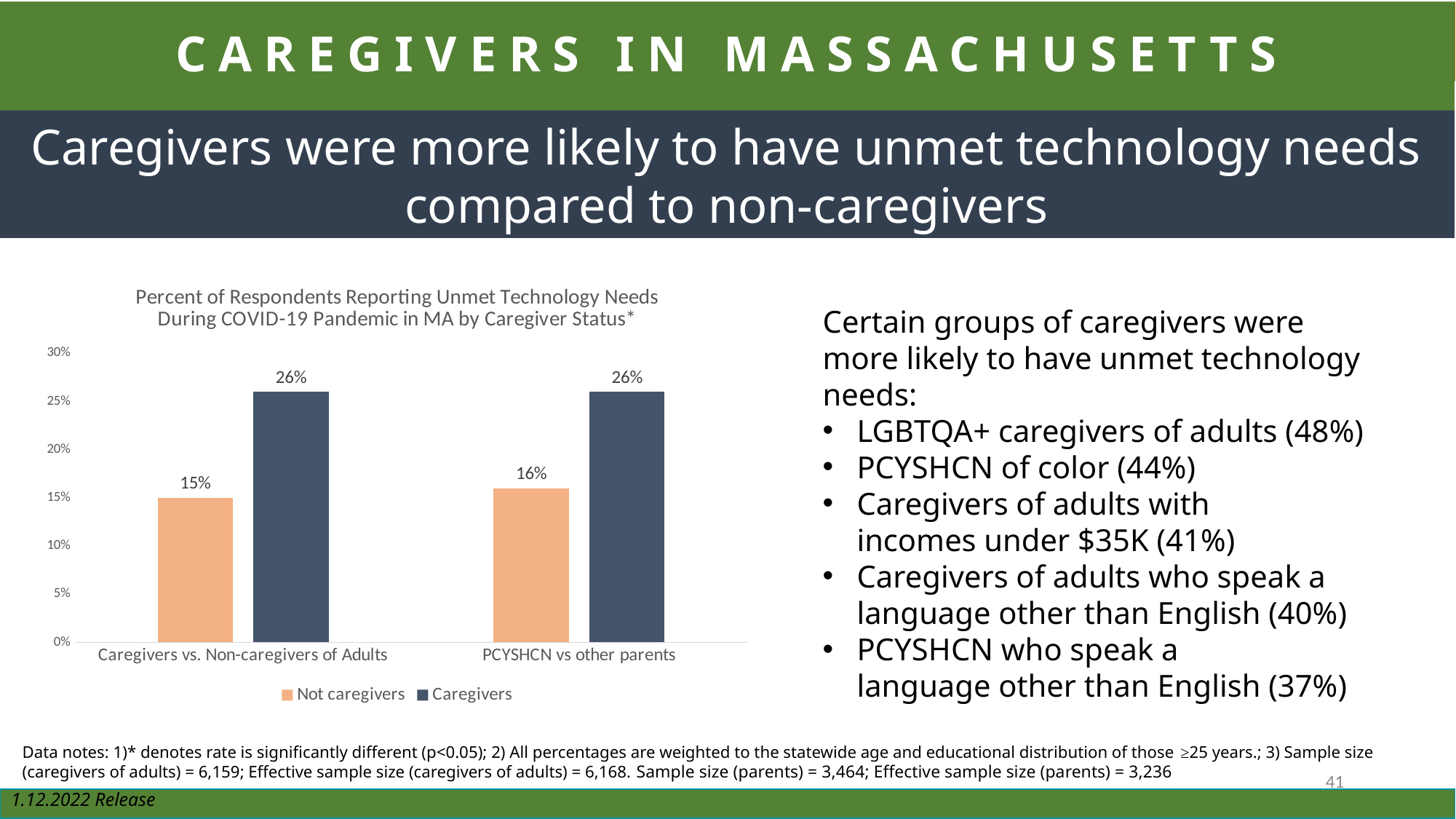
What type of chart is shown on the slide? Bar chart What colour represents the 'Not caregivers' series in the chart? Orange What is the difference between the 'Caregivers' and 'Not caregivers' values in the 'PCYSHCN vs other parents' category? 10% Is the value for 'Not caregivers' in the 'PCYSHCN vs other parents' category greater or less than 20%? less What is the value for 'Caregivers' in the 'PCYSHCN vs other parents' category? 26% What is the difference between caregivers and non-caregivers of adults in reporting unmet technology needs? 11% How many series does the chart legend list? 2 What percentage of non-caregivers of adults reported unmet technology needs? 15% What percentage of caregivers in the 'Caregivers vs. Non-caregivers of Adults' group reported unmet technology needs? 26% Which series has the higher value in the 'Caregivers vs. Non-caregivers of Adults' category? Caregivers How many categories are shown on the x axis of the chart? 2 What is the value for 'Not caregivers' in the 'PCYSHCN vs other parents' category? 16%